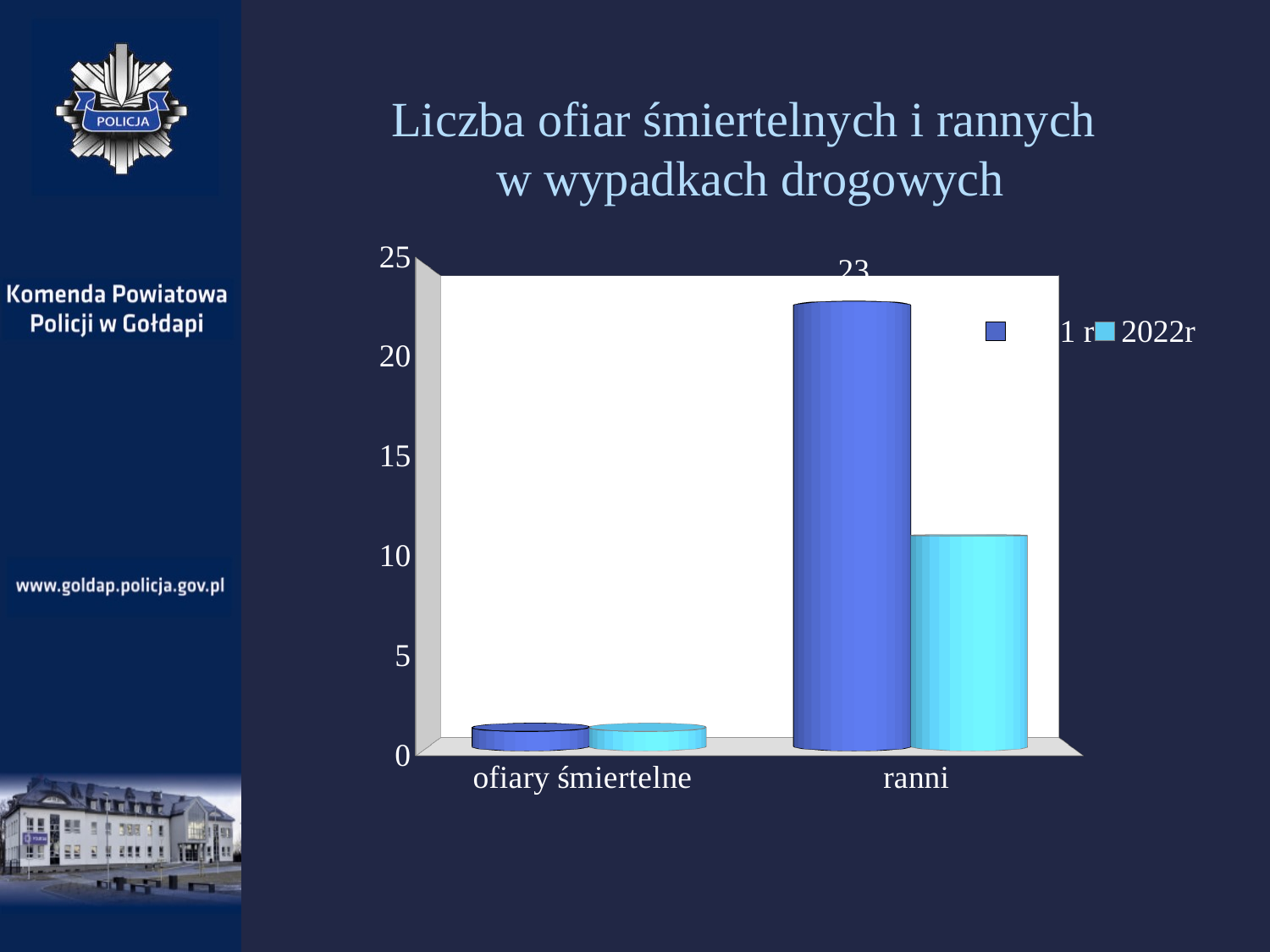
Which category has the highest bars in the chart? ranni What colour represents the 2022r series in the legend? light blue What value is printed on the dark blue bar for 'ranni'? 23 How many series does the chart's legend list? 2 What kind of chart is shown on the slide? bar chart Is the 2022r value for 'ranni' greater or less than 15? less Which category has the lowest bars in the chart? ofiary śmiertelne How many categories are shown on the x axis of the chart? 2 Is the dark blue bar for 'ranni' greater or less than 20? greater Is the 2022r value for 'ofiary śmiertelne' greater or less than 5? less What is the title of the chart on the slide? Liczba ofiar śmiertelnych i rannych w wypadkach drogowych For 'ranni', which bar is taller: the dark blue bar or the 2022r bar? the dark blue bar